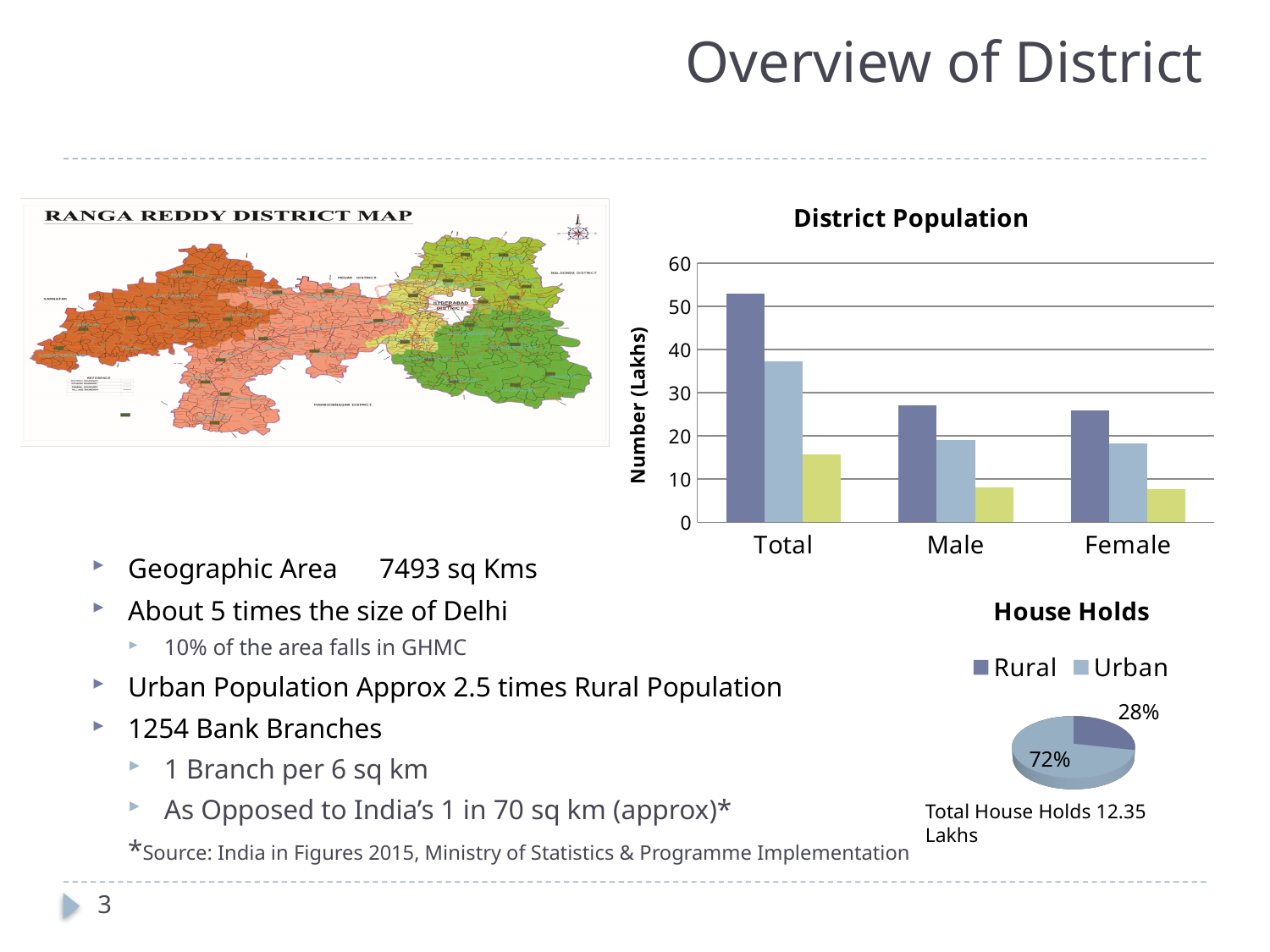
What kind of chart is the District Population chart? bar chart How many entries does the legend of the House Holds chart list? 2 In the House Holds chart, what share of households is Urban? 72% What kind of chart is the House Holds chart? pie chart In the District Population chart, is the value of the third (yellow) bar for Total greater or less than 20? less In the District Population chart, which category has the tallest bar? Total What is the y-axis title of the District Population chart? Number (Lakhs) How many categories are shown on the x axis of the District Population chart? 3 In the District Population chart, is the value of the yellow bar for Male greater or less than 10? less In the House Holds chart, what is the difference between the Urban and Rural shares? 44 percentage points In the District Population chart, is the value of the first (dark blue) bar for Total greater or less than 50? greater In the District Population chart, is the light blue bar larger for Total or for Male? Total